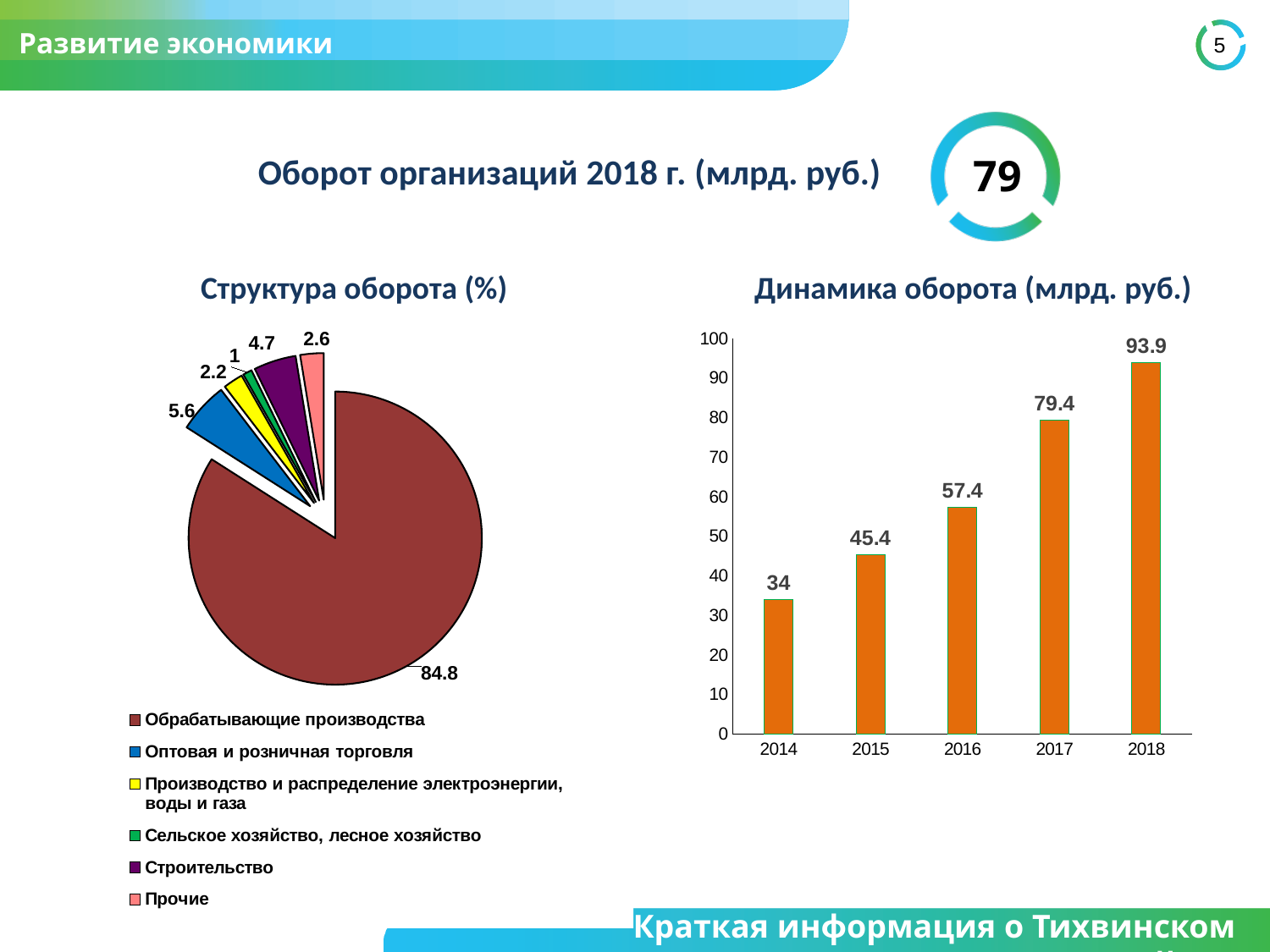
In the pie chart 'Структура оборота (%)', which is larger: 'Оптовая и розничная торговля' or 'Прочие'? Оптовая и розничная торговля In the chart 'Динамика оборота (млрд. руб.)', which year has the lowest value? 2014 In the chart 'Динамика оборота (млрд. руб.)', do the values rise or fall from 2014 to 2018? rise In the chart 'Динамика оборота (млрд. руб.)', which year has the highest value? 2018 What kind of chart is 'Динамика оборота (млрд. руб.)'? bar chart In the chart 'Динамика оборота (млрд. руб.)', what is the difference between the values for 2018 and 2017? 14.5 How many categories does the legend of the pie chart 'Структура оборота (%)' list? 6 In the pie chart 'Структура оборота (%)', what is the value for 'Обрабатывающие производства'? 84.8 How many bars are in the chart 'Динамика оборота (млрд. руб.)'? 5 In the pie chart 'Структура оборота (%)', what is the value for 'Строительство'? 4.7 In the chart 'Динамика оборота (млрд. руб.)', what is the value for 2014? 34 In the chart 'Динамика оборота (млрд. руб.)', what is the value for 2016? 57.4